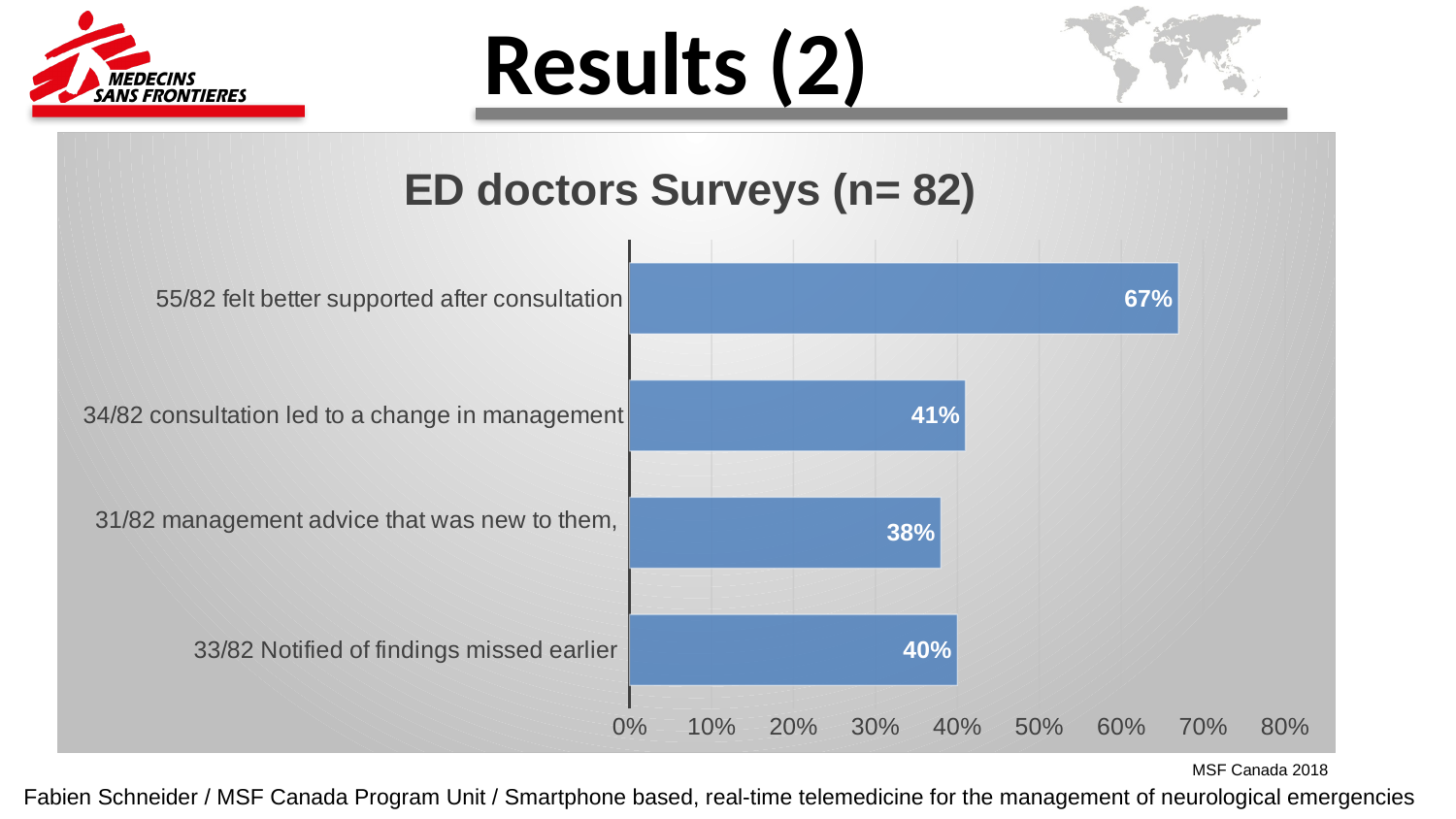
Which category has the highest value? 55/82 felt better supported after consultation What is the title of the chart? ED doctors Surveys (n= 82) Is the value for '55/82 felt better supported after consultation' greater or less than 60%? greater Which category has the lowest value? 31/82 management advice that was new to them What is the value for '55/82 felt better supported after consultation'? 67% What is the value for '33/82 Notified of findings missed earlier'? 40% What is the value for '31/82 management advice that was new to them'? 38% How many categories are shown in the chart? 4 What is the difference between the value for '55/82 felt better supported after consultation' and '34/82 consultation led to a change in management'? 26% Which is larger: the value for '33/82 Notified of findings missed earlier' or '31/82 management advice that was new to them'? 33/82 Notified of findings missed earlier What is the value for '34/82 consultation led to a change in management'? 41% What kind of chart is shown on the slide? bar chart